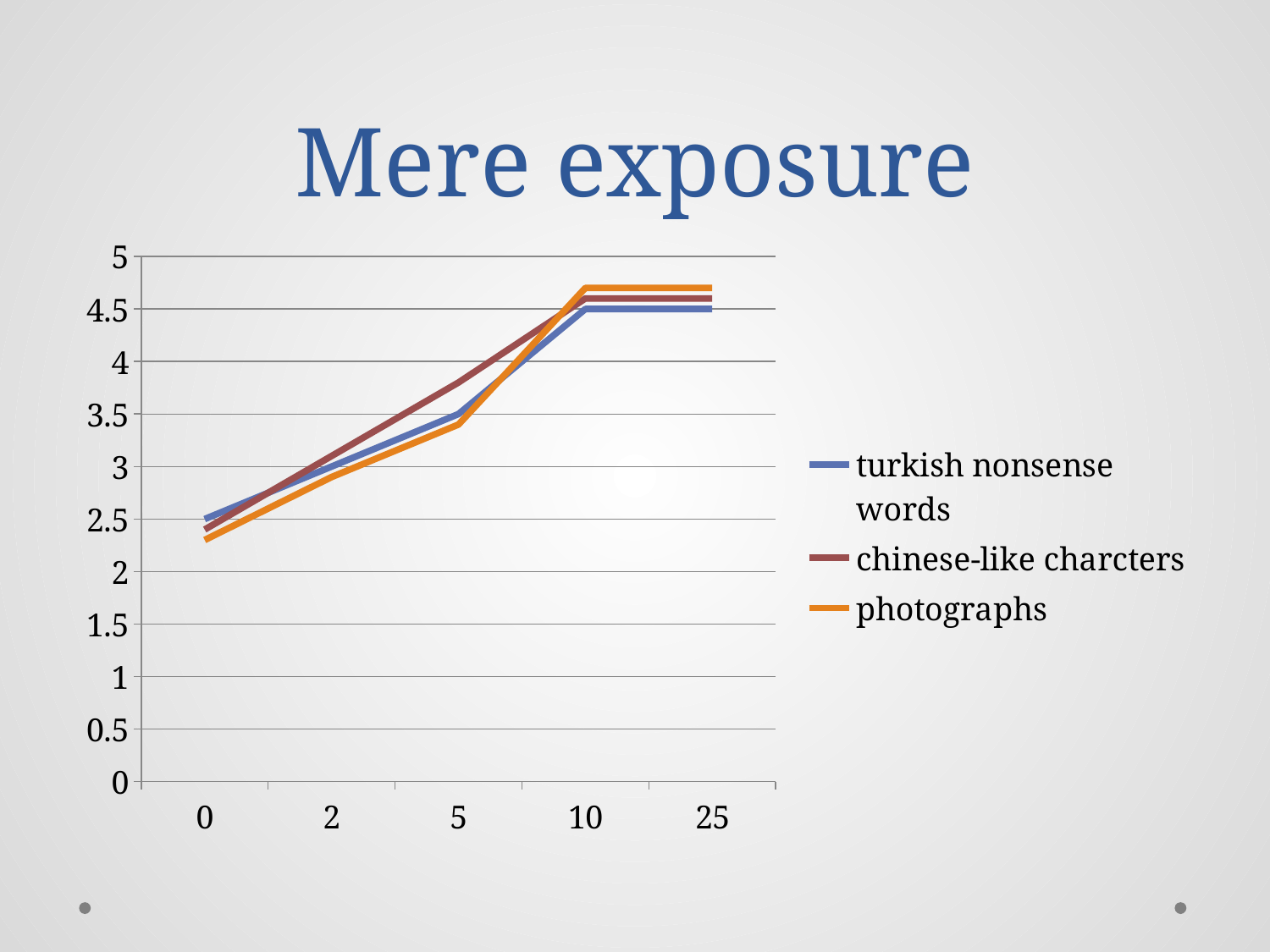
What is the title of the slide? Mere exposure What kind of chart is shown on the slide? line chart Is the value for photographs at 10 greater or less than 4.5? greater At 0, which series has the higher value: turkish nonsense words or photographs? turkish nonsense words Do the values for photographs rise or fall from 0 to 10 along the x axis? rise At 5, which series has the higher value: chinese-like charcters or photographs? chinese-like charcters Is the value for chinese-like charcters at 5 greater or less than 3.5? greater Is the value for turkish nonsense words at 2 greater or less than 2.5? greater How many series does the legend list? 3 How many points are marked along the x axis? 5 At 5, which series has the highest value? chinese-like charcters